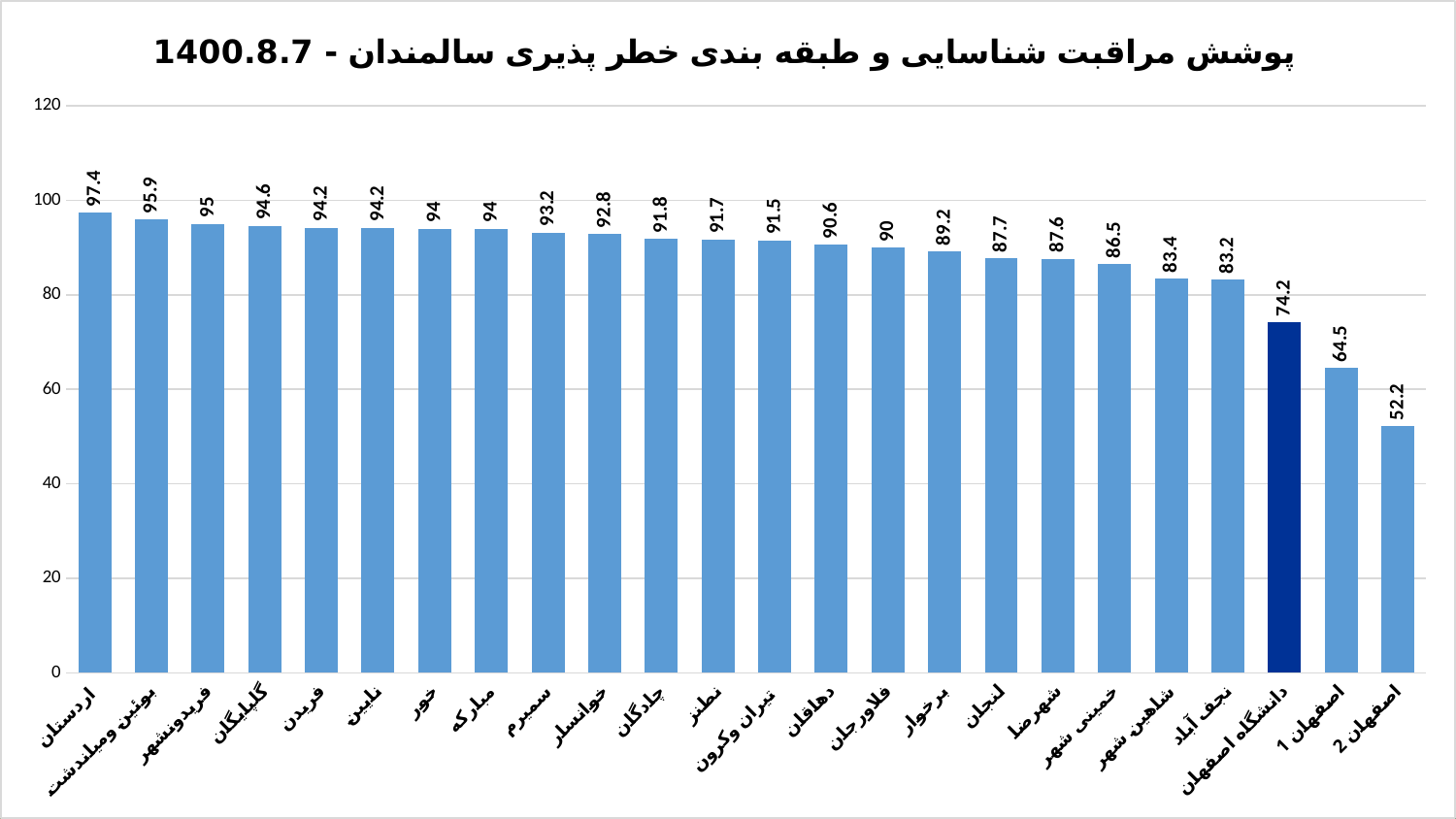
Which is larger, the value for اصفهان 1 or the value for دانشگاه اصفهان? دانشگاه اصفهان Which bar is shown in a darker blue colour than the others? دانشگاه اصفهان Which category has the highest value? اردستان What is the difference between the values for اردستان and اصفهان 2? 45.2 What is the value for دانشگاه اصفهان? 74.2 What is the value for نجف آباد? 83.2 What is the value for اردستان? 97.4 Is the value for شاهین شهر greater or less than 80? greater How many categories are shown on the x axis? 24 What is the value for اصفهان 2? 52.2 Which category has the lowest value? اصفهان 2 What kind of chart is shown on the slide? bar chart